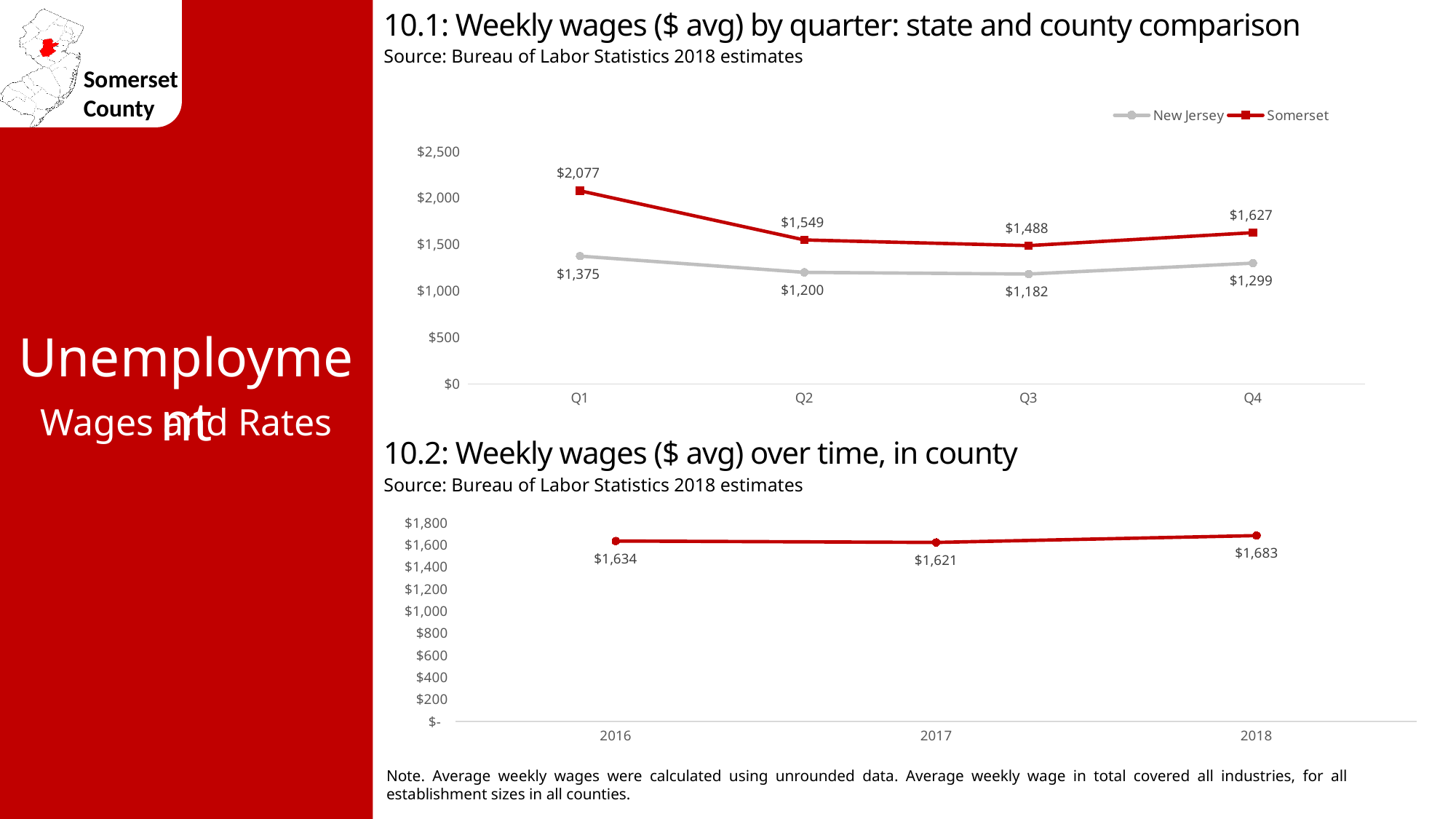
In chart 10.1, which series has the higher weekly wage in Q2, New Jersey or Somerset? Somerset In chart 10.2, what is the difference between the weekly wages in 2018 and 2016? $49 In chart 10.2, which year has the highest weekly wage? 2018 In chart 10.1, how many series does the legend list? 2 In chart 10.1, which quarter has the highest New Jersey weekly wage? Q1 In chart 10.1, what is the Somerset weekly wage in Q1? $2,077 In chart 10.1, what is the difference between the Somerset and New Jersey weekly wages in Q4? $328 In chart 10.1, which quarter has the lowest Somerset weekly wage? Q3 In chart 10.1, what is the New Jersey weekly wage in Q3? $1,182 In chart 10.2, how many years are plotted? 3 In chart 10.2, what is the weekly wage in 2017? $1,621 In chart 10.1, what kind of chart is shown? Line chart